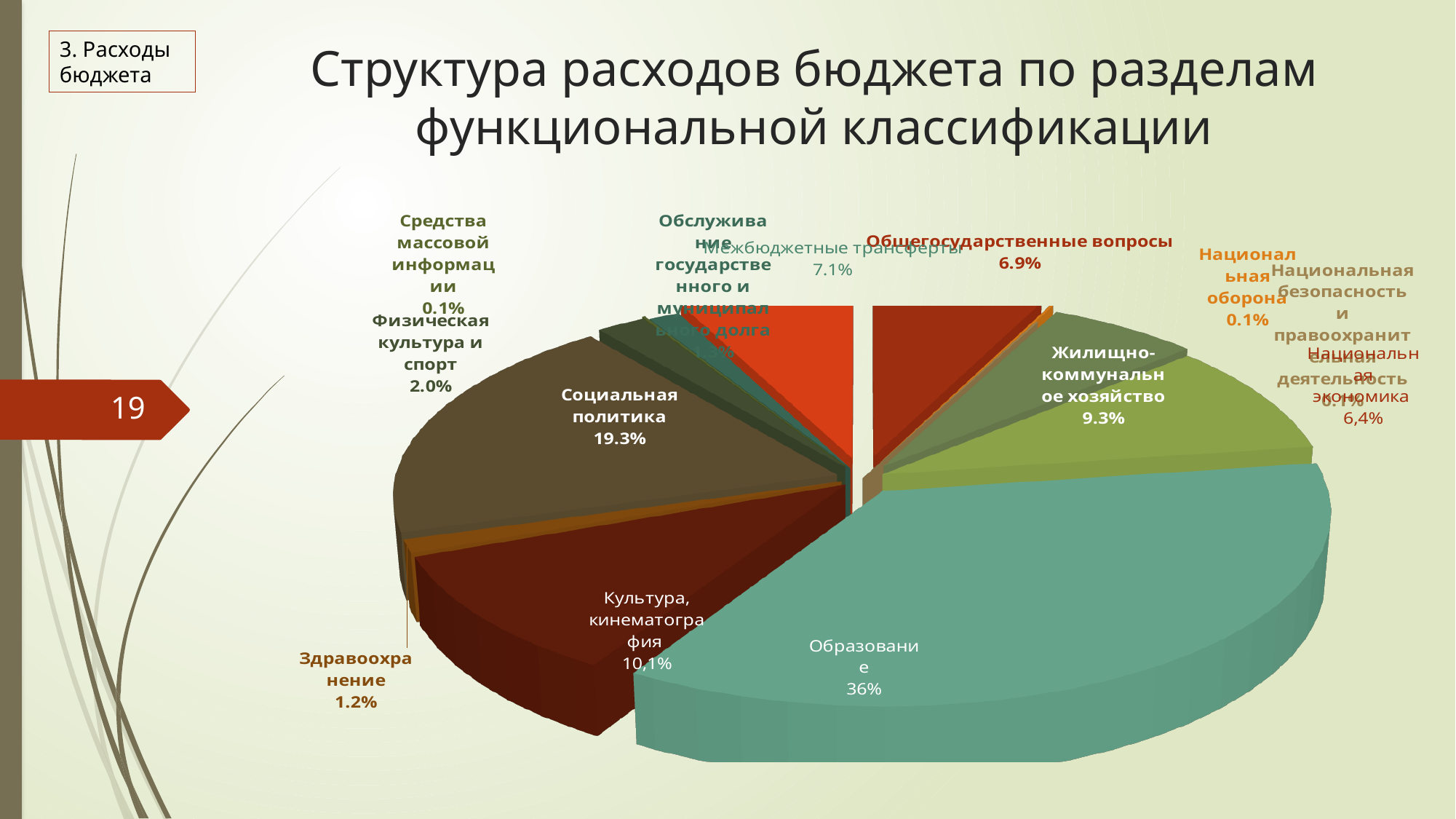
What is the title of the chart on the slide? Структура расходов бюджета по разделам функциональной классификации What percentage is shown for Жилищно-коммунальное хозяйство? 9.3% What is the difference between the shares of Образование and Социальная политика? 16.7% What is the difference between Общегосударственные вопросы and Национальная экономика? 0.5% What percentage is labelled for Межбюджетные трансферты? 7.1% What is the value shown for Здравоохранение? 1.2% What is the value shown for Социальная политика? 19.3% Which is larger, Социальная политика or Жилищно-коммунальное хозяйство? Социальная политика What kind of chart is shown on the slide? pie chart What share of budget expenditure goes to Образование? 36% Which section has the largest share of budget expenditure? Образование What is the value for Культура, кинематография? 10,1%